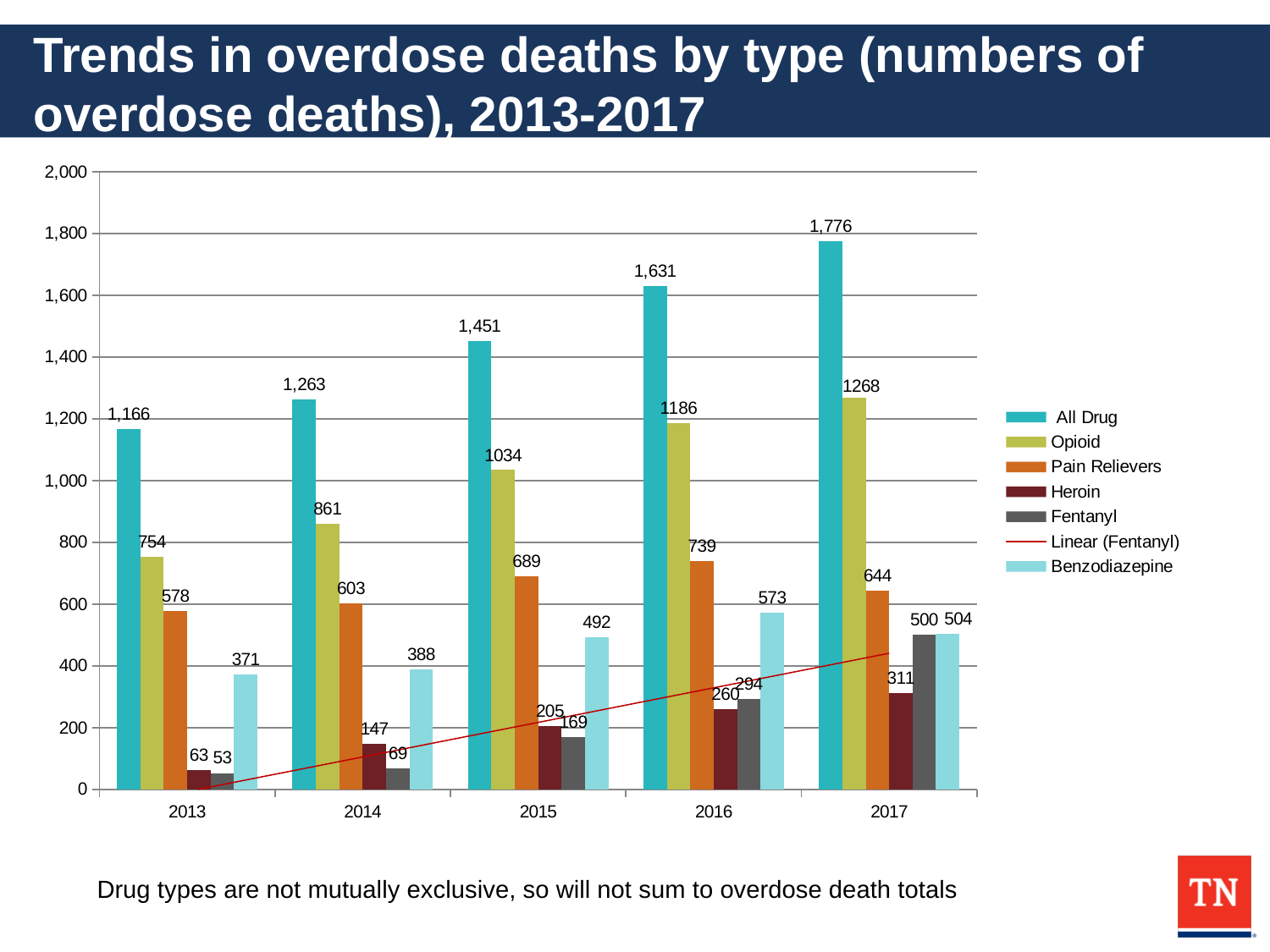
In which year is the Opioid value highest? 2017 How many years are shown on the x axis? 5 In which year is the Heroin value lowest? 2013 How many entries does the legend list? 7 Is the value for Opioid in 2015 greater or less than 1,000? greater What is the value for Fentanyl in 2013? 53 Does the All Drug value rise or fall from 2013 to 2017? rise What is the value for Benzodiazepine in 2016? 573 What is the value for Pain Relievers in 2015? 689 What is the difference between the All Drug values for 2017 and 2016? 145 What is the value for All Drug in 2017? 1,776 Which is larger in 2017, Fentanyl or Heroin? Fentanyl